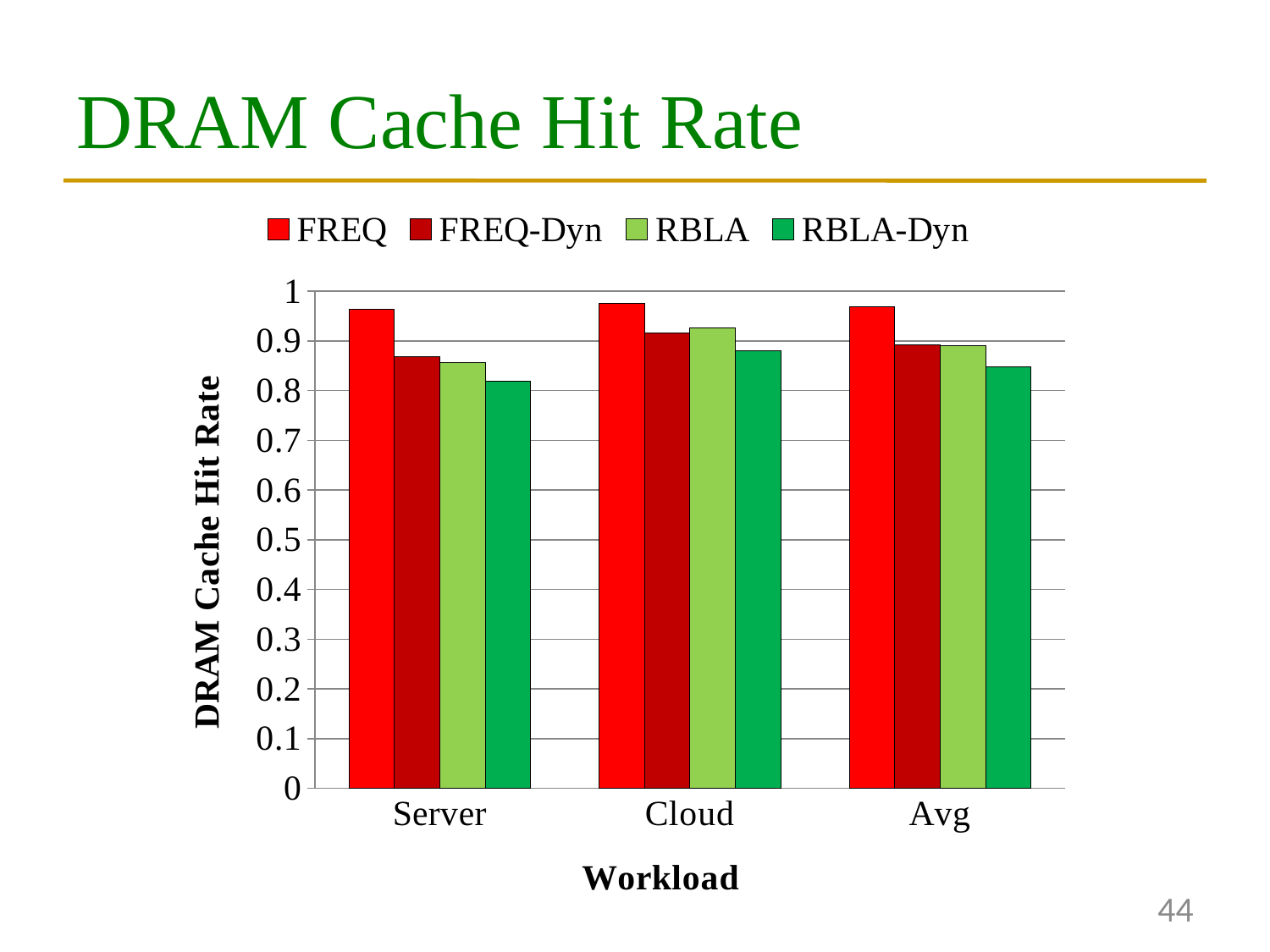
Which series has the lowest DRAM cache hit rate for the Avg workload? RBLA-Dyn How many series does the legend list? 4 How many workload categories are shown on the x axis? 3 What is the label of the y axis? DRAM Cache Hit Rate For the Server workload, which is larger: the FREQ-Dyn bar or the RBLA-Dyn bar? FREQ-Dyn What is the label of the x axis? Workload Is the DRAM cache hit rate for RBLA-Dyn on the Server workload greater or less than 0.9? less What kind of chart is shown on the slide? bar chart Is the DRAM cache hit rate for FREQ on the Cloud workload greater or less than 0.9? greater Which series has the lowest DRAM cache hit rate for the Server workload? RBLA-Dyn Which series has the highest DRAM cache hit rate for the Server workload? FREQ Is the DRAM cache hit rate for RBLA-Dyn on the Avg workload greater or less than 0.9? less